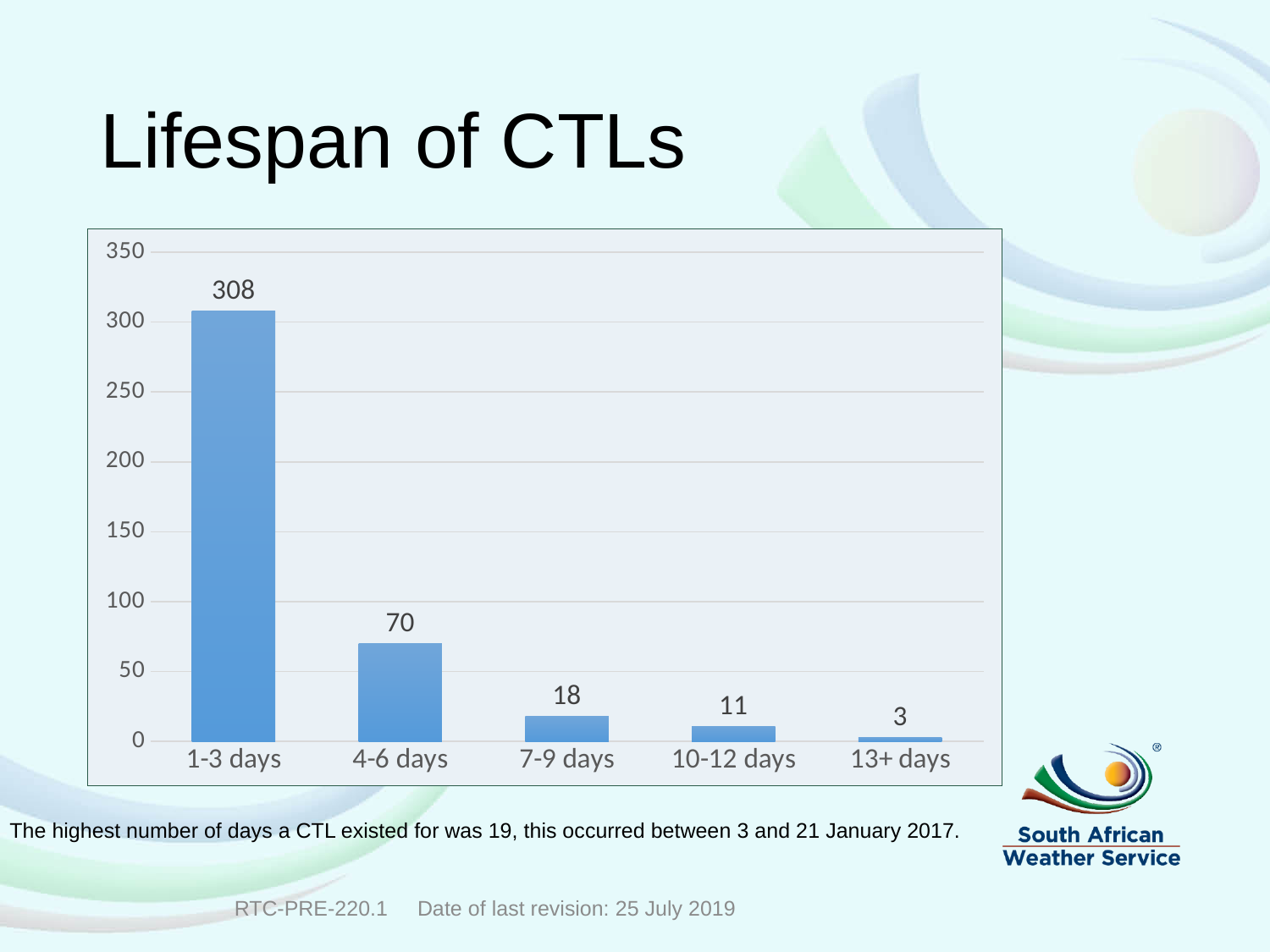
What is the value for the 7-9 days category? 18 What is the difference between the values for 1-3 days and 4-6 days? 238 What kind of chart is shown on the slide? Bar chart Which is larger, the value for 7-9 days or the value for 10-12 days? 7-9 days What is the value for the 4-6 days category? 70 What is the value for the 1-3 days category? 308 What is the value for the 13+ days category? 3 Which category has the highest value? 1-3 days How many categories are shown on the x axis? 5 Do the values rise or fall moving from left to right along the x axis? Fall Which category has the lowest value? 13+ days What is the value for the 10-12 days category? 11